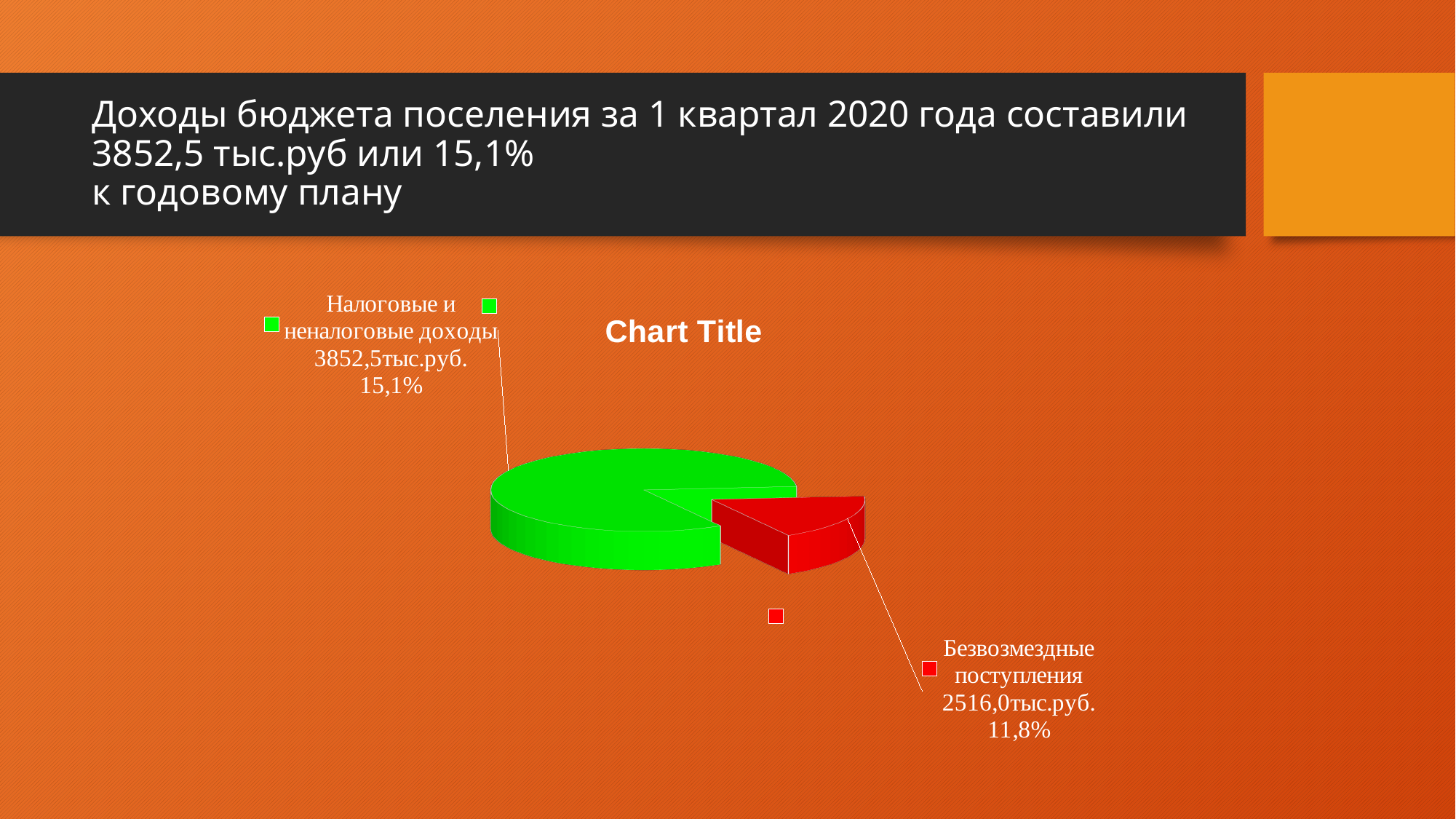
Which slice of the pie chart is the largest? Налоговые и неналоговые доходы What is the difference in тыс.руб. between Налоговые и неналоговые доходы and Безвозмездные поступления? 1336,5 тыс.руб. What colour is the slice for Безвозмездные поступления? red What percentage is printed on the label for Безвозмездные поступления? 11,8% How many slices does the pie chart have? 2 Which slice of the pie chart is the smallest? Безвозмездные поступления Which is larger: Налоговые и неналоговые доходы or Безвозмездные поступления? Налоговые и неналоговые доходы What kind of chart is shown on the slide? pie chart What is the title shown above the pie chart? Chart Title What percentage is printed on the label for Налоговые и неналоговые доходы? 15,1% What value in тыс.руб. is shown for Безвозмездные поступления? 2516,0тыс.руб. What value in тыс.руб. is shown for Налоговые и неналоговые доходы? 3852,5тыс.руб.